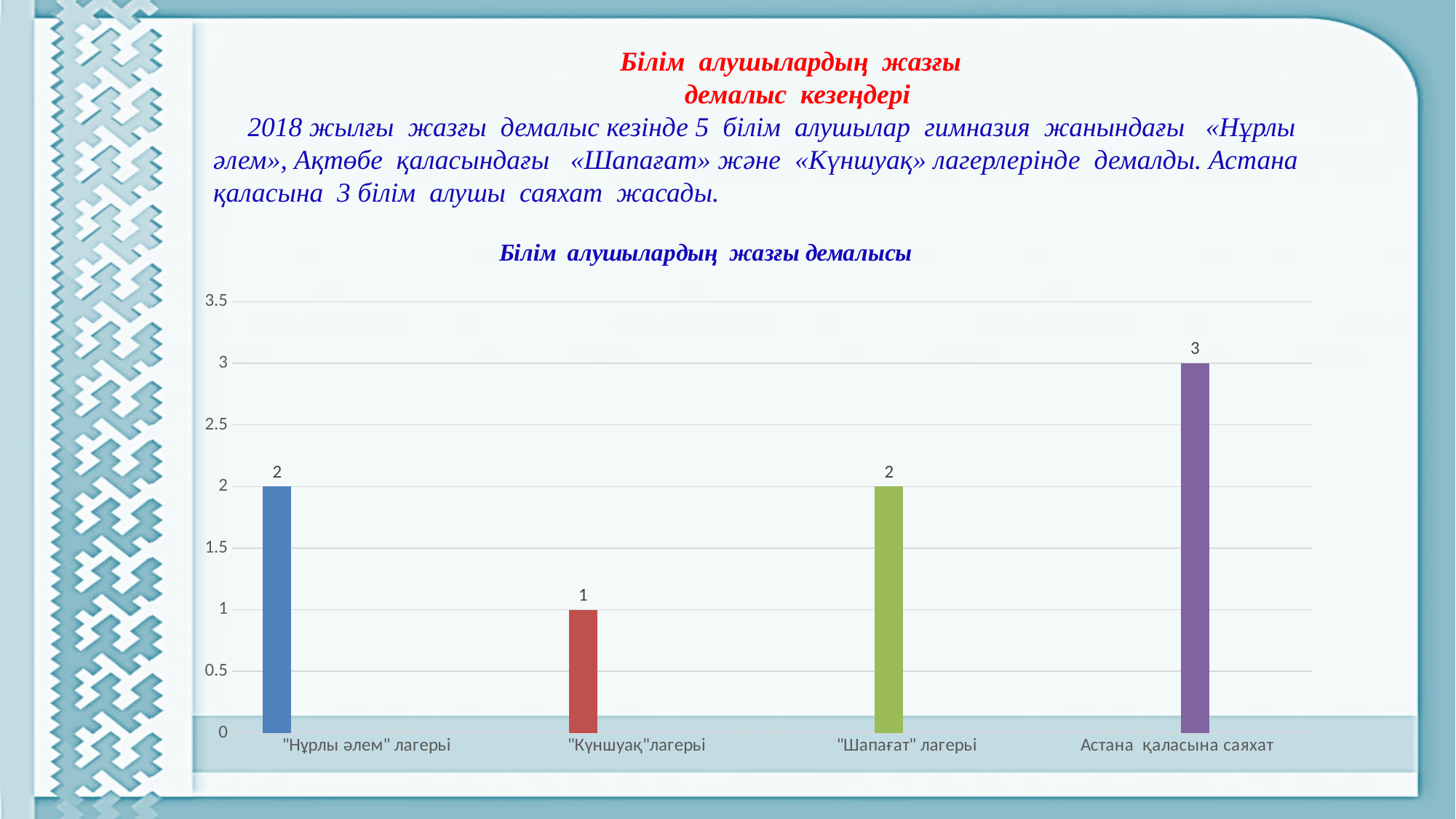
What is the title of the chart? Білім алушылардың жазғы демалысы Which category has the lowest value? "Күншуақ" лагері What is the value for "Шапағат" лагері? 2 What is the value for Астана қаласына саяхат? 3 What kind of chart is shown on the slide? bar chart What is the value for "Нұрлы әлем" лагері? 2 Is the value for Астана қаласына саяхат greater or less than 2.5? greater What is the difference between the values for Астана қаласына саяхат and "Күншуақ" лагері? 2 What is the value for "Күншуақ" лагері? 1 Which is larger, the value for "Нұрлы әлем" лагері or the value for "Күншуақ" лагері? "Нұрлы әлем" лагері How many categories are shown on the chart? 4 Which category has the highest value? Астана қаласына саяхат